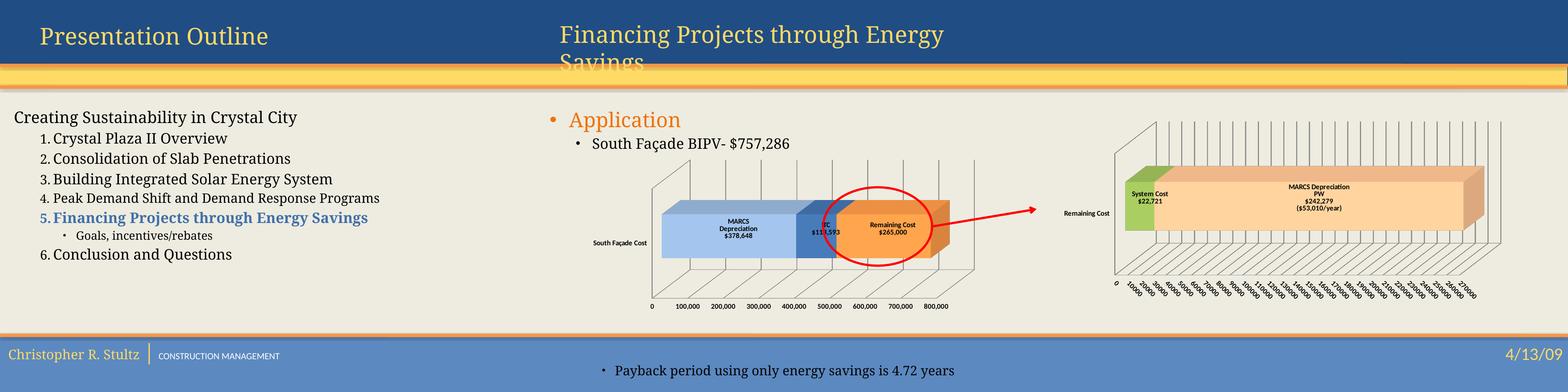
In the Remaining Cost chart on the right, which segment is larger, System Cost or MARCS Depreciation PW? MARCS Depreciation PW In the Remaining Cost chart on the right, what is the value of the System Cost segment? $22,721 In the South Façade Cost chart, what is the value of the Remaining Cost segment? $265,000 In the South Façade Cost chart, what is the value of the MARCS Depreciation segment? $378,648 In the Remaining Cost chart on the right, what annual value is shown for MARCS Depreciation PW? $53,010/year In the South Façade Cost chart, how much larger is the MARCS Depreciation segment than the Remaining Cost segment? $113,648 In the Remaining Cost chart on the right, what is the total of the two segments? $265,000 How many segments make up the bar in the South Façade Cost chart? 3 What kind of chart is the South Façade Cost chart? Bar chart In the South Façade Cost chart, which segment is the largest? MARCS Depreciation In the Remaining Cost chart on the right, what is the difference between the MARCS Depreciation PW and System Cost segments? $219,558 In the Remaining Cost chart on the right, what is the value of the MARCS Depreciation PW segment? $242,279